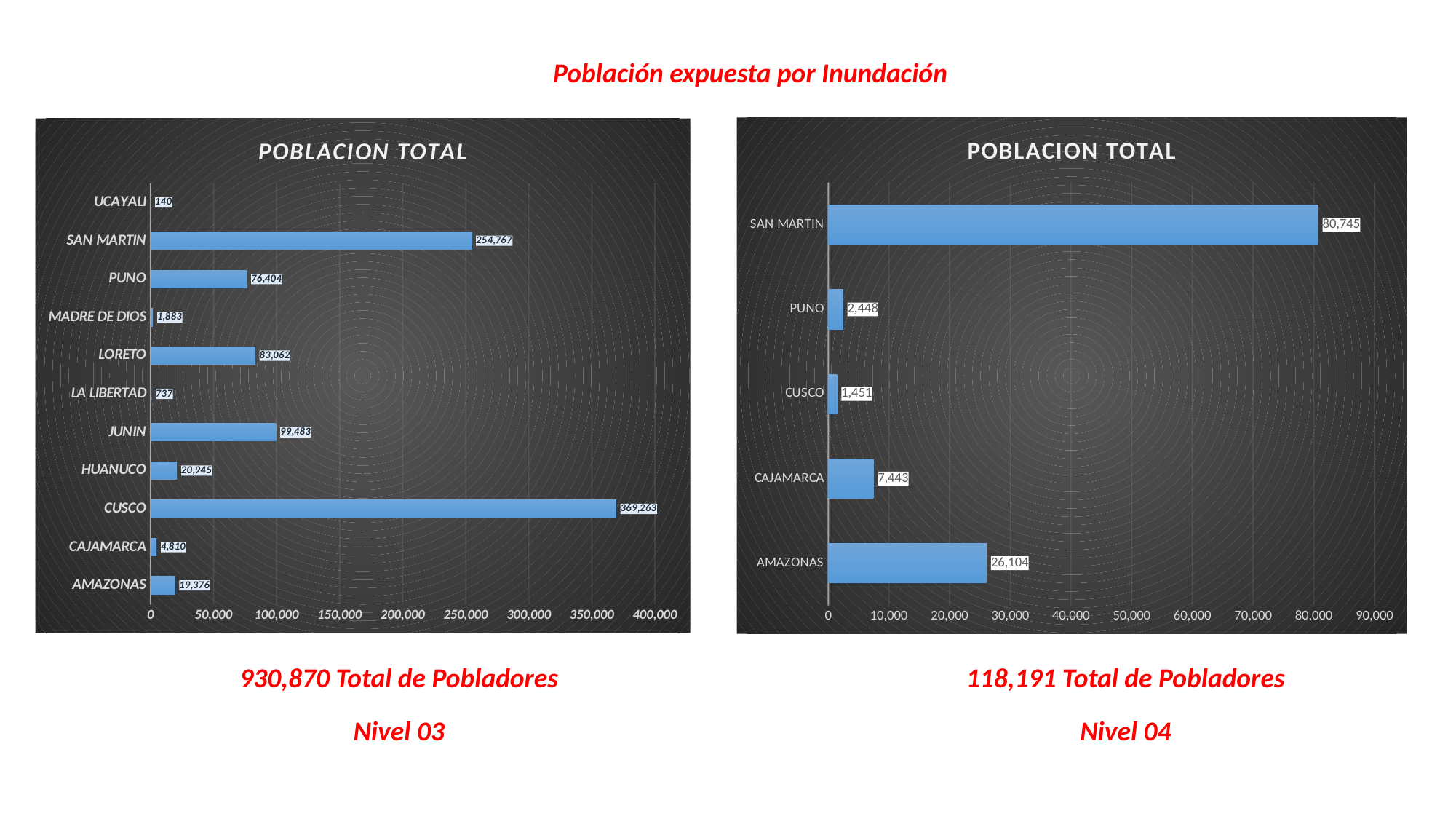
In the left chart (Nivel 03), which category has the lowest value? UCAYALI In the right chart (Nivel 04), which category has the highest value? SAN MARTIN How many categories are shown in the right chart (Nivel 04)? 5 How many categories are shown in the left chart (Nivel 03)? 11 In the left chart (Nivel 03), what is the difference between the values for CUSCO and SAN MARTIN? 114,496 What type of chart is the right chart (Nivel 04)? Bar chart In the left chart (Nivel 03), what is the value for SAN MARTIN? 254,767 In the right chart (Nivel 04), what is the difference between the values for CAJAMARCA and PUNO? 4,995 In the left chart (Nivel 03), what is the value for CUSCO? 369,263 In the left chart (Nivel 03), which is larger, the value for JUNIN or the value for LORETO? JUNIN In the right chart (Nivel 04), which category has the lowest value? CUSCO In the right chart (Nivel 04), what is the value for AMAZONAS? 26,104